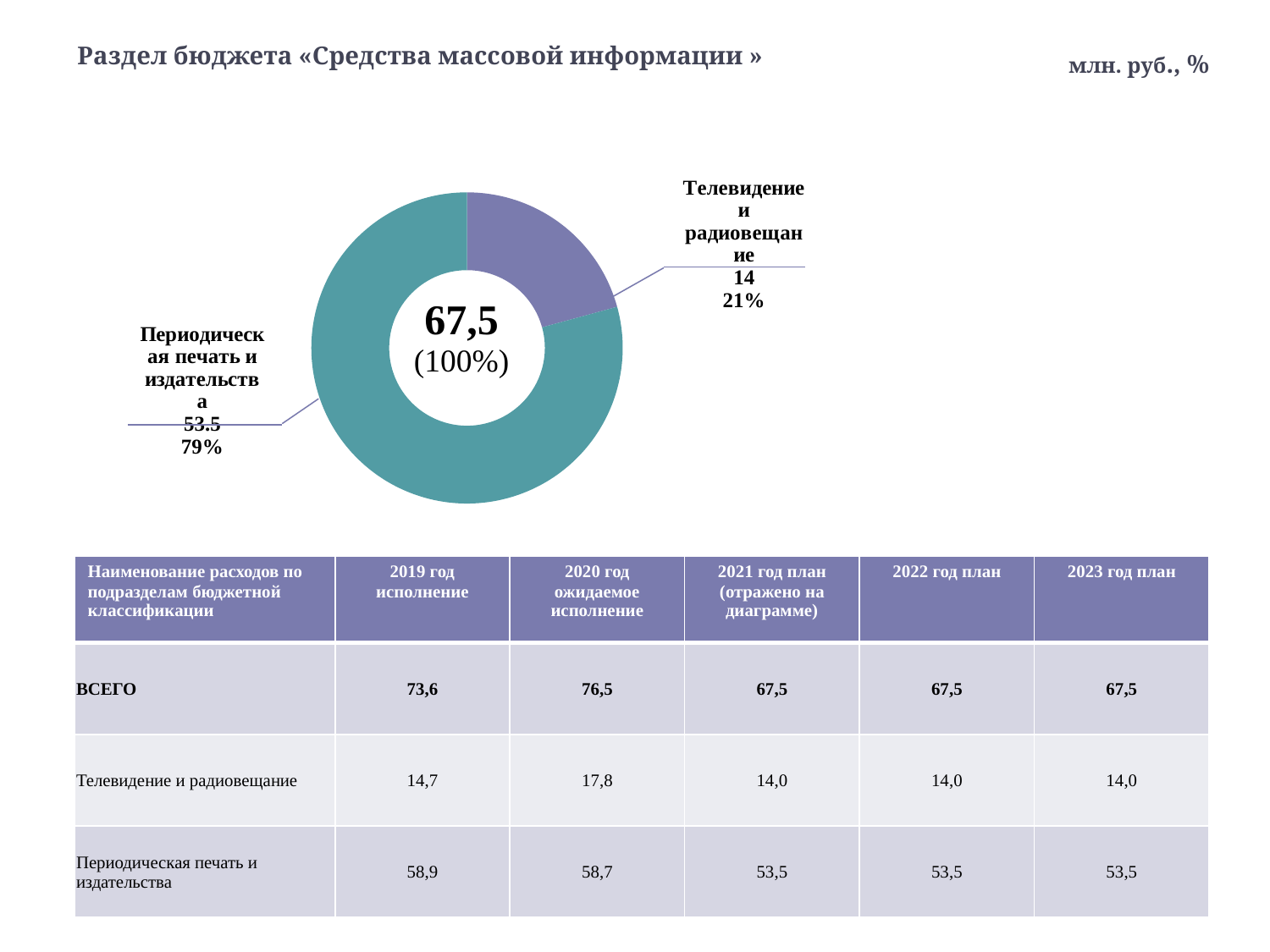
What share of the donut chart does «Телевидение и радиовещание» represent? 21% What is the title of the slide containing the donut chart? Раздел бюджета «Средства массовой информации » What kind of chart is shown on the slide? Pie (donut) chart Which is larger on the donut chart: «Телевидение и радиовещание» or «Периодическая печать и издательства»? Периодическая печать и издательства Which slice of the donut chart is the smallest? Телевидение и радиовещание Which slice of the donut chart is the largest? Периодическая печать и издательства What share of the donut chart does «Периодическая печать и издательства» represent? 79% What total value is shown in the centre of the donut chart? 67,5 What value is shown for «Телевидение и радиовещание» on the donut chart? 14 By how much does the value for «Периодическая печать и издательства» exceed the value for «Телевидение и радиовещание» on the donut chart? 39.5 How many slices does the donut chart have? 2 What value is shown for «Периодическая печать и издательства» on the donut chart? 53.5